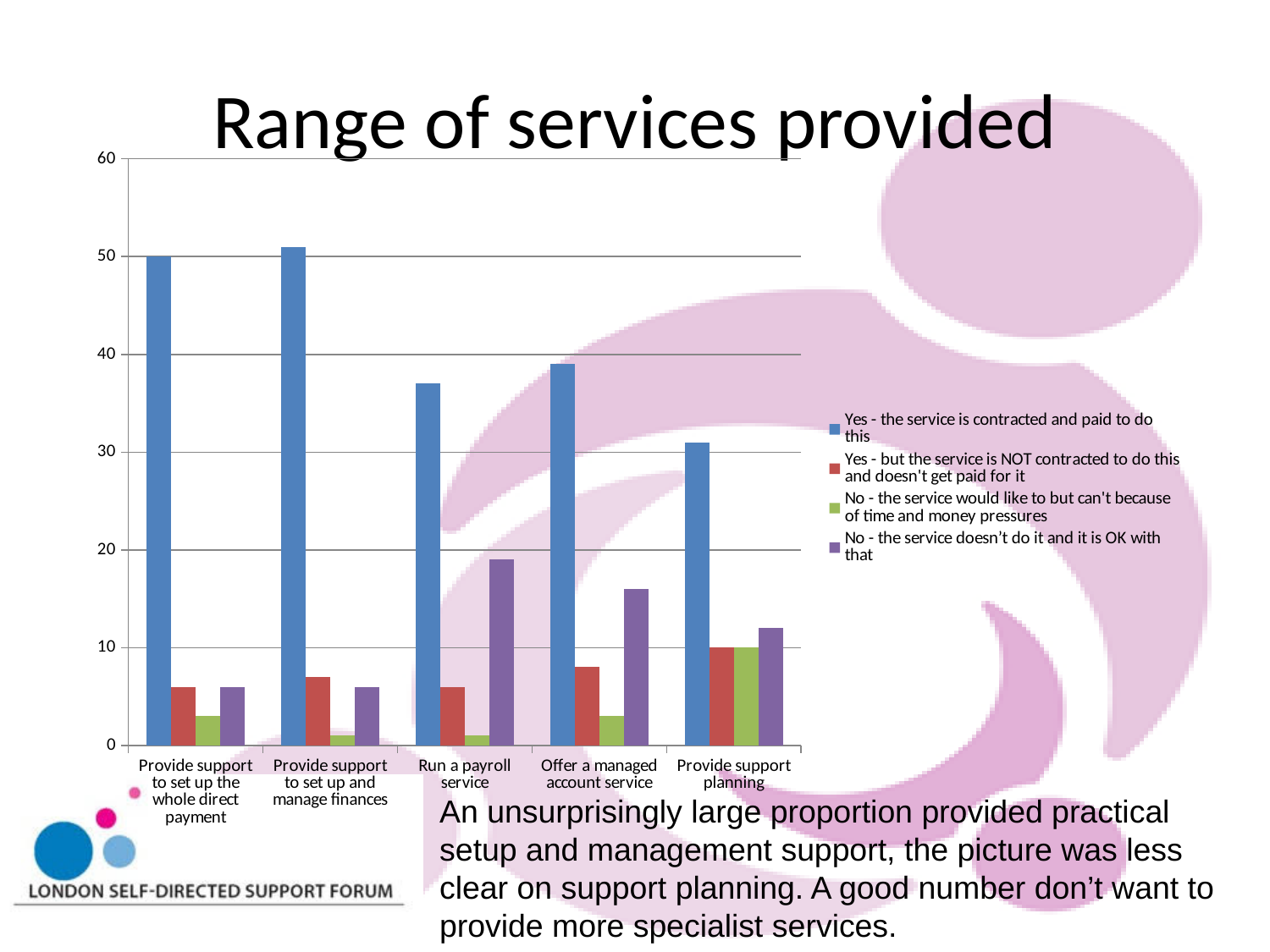
Which colour represents the series 'Yes - the service is contracted and paid to do this'? blue What is the title of the chart? Range of services provided Which category has the highest value for 'No - the service doesn't do it and it is OK with that'? Run a payroll service What kind of chart is shown on the slide? bar chart Is the value of 'No - the service would like to but can't because of time and money pressures' for 'Provide support to set up and manage finances' greater or less than 10? less Is the value of 'Yes - the service is contracted and paid to do this' for 'Run a payroll service' greater or less than 40? less How many service categories are shown along the x axis? 5 How many series does the legend list? 4 Is the value of 'No - the service doesn't do it and it is OK with that' for 'Run a payroll service' greater or less than 10? greater Which category has the lowest value for 'Yes - the service is contracted and paid to do this'? Provide support planning For 'No - the service doesn't do it and it is OK with that', which is larger: 'Offer a managed account service' or 'Provide support planning'? Offer a managed account service What is the value of 'Yes - the service is contracted and paid to do this' for 'Provide support to set up the whole direct payment'? 50